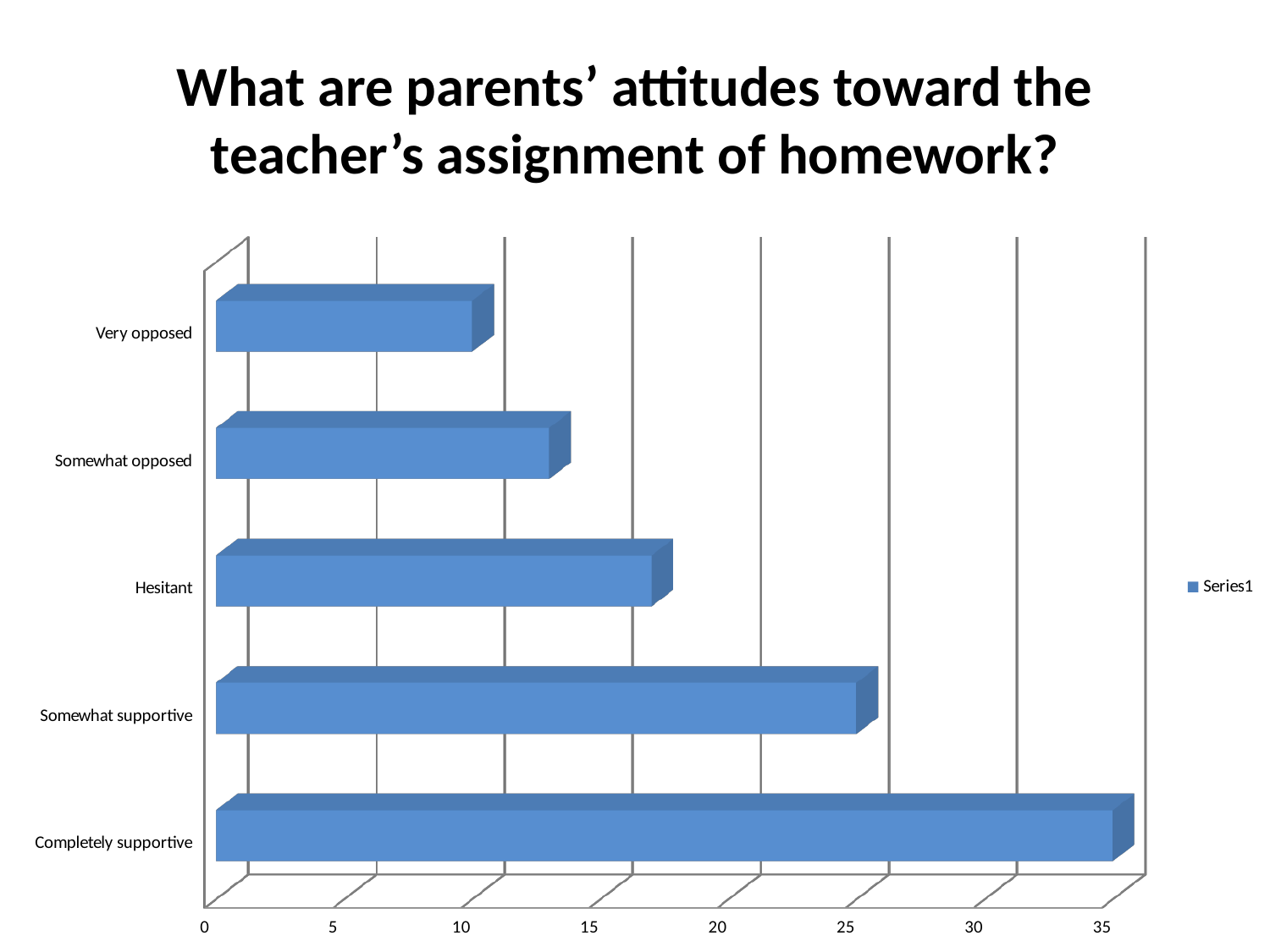
What kind of chart is shown on the slide? bar chart How many categories are plotted in the chart? 5 Which is larger, the value for Somewhat supportive or the value for Hesitant? Somewhat supportive Is the value for Hesitant greater or less than 20? less Which is larger, the value for Somewhat opposed or the value for Very opposed? Somewhat opposed How many series does the legend list? 1 Is the value for Completely supportive greater or less than 30? greater Is the value for Somewhat supportive greater or less than 20? greater Which category has the highest value? Completely supportive Which category has the lowest value? Very opposed What is the name of the series shown in the legend? Series1